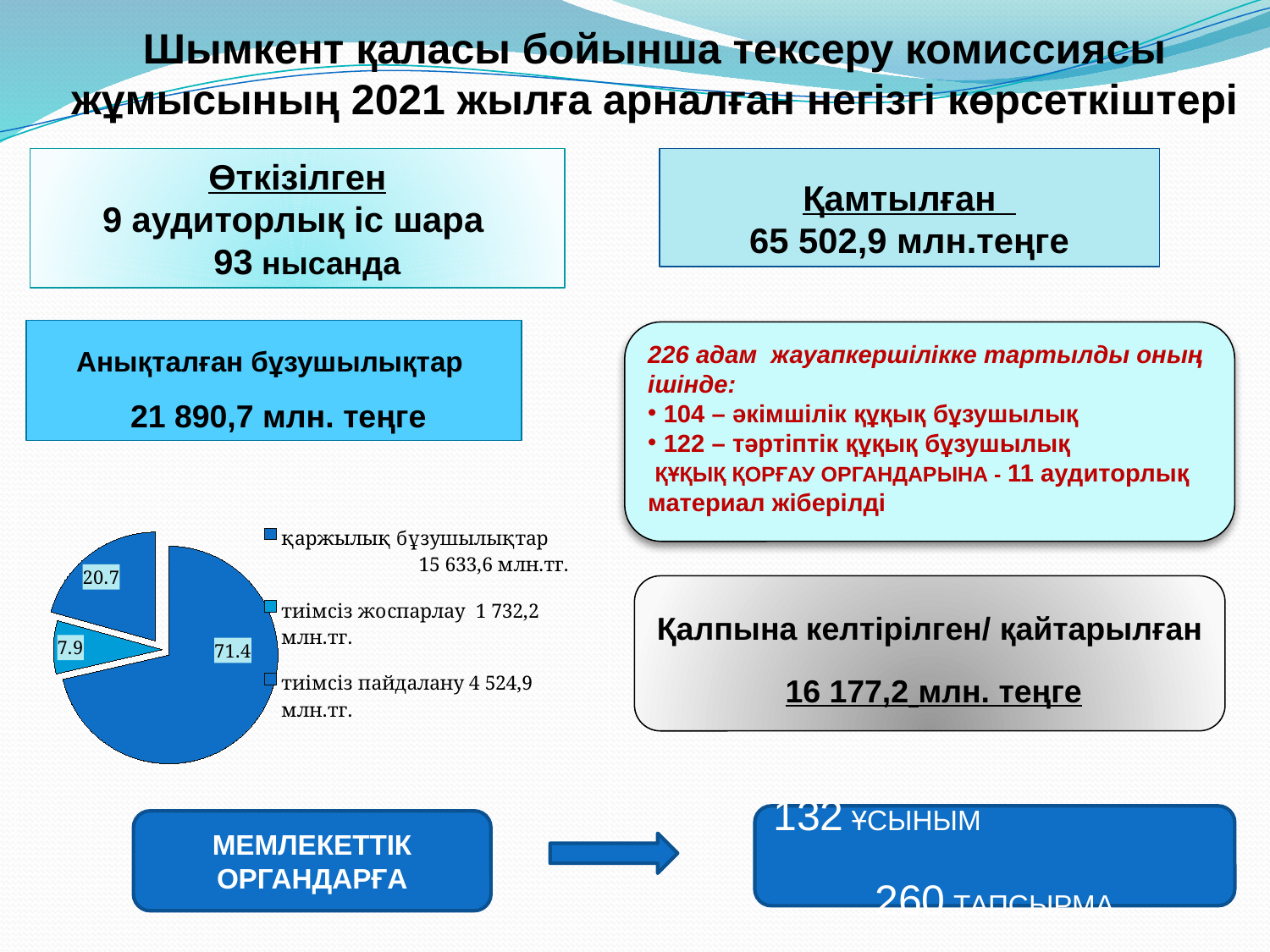
How many entries does the legend of the pie chart list? 3 According to the legend, what amount in млн.тг. is given for қаржылық бұзушылықтар? 15 633,6 млн.тг. According to the legend, what amount in млн.тг. is given for тиімсіз пайдалану? 4 524,9 млн.тг. What kind of chart is shown on the slide? pie chart Which legend category corresponds to the largest slice of the pie chart? қаржылық бұзушылықтар What is the difference between the slice labelled 20.7 and the slice labelled 7.9? 12.8 What is the difference between the slice labelled 71.4 and the slice labelled 20.7? 50.7 How many slices does the pie chart have? 3 Which legend category corresponds to the smallest slice of the pie chart? тиімсіз жоспарлау Which slice is larger: the one labelled 20.7 or the one labelled 7.9? 20.7 What value is labelled on the smallest slice of the pie chart? 7.9 What value is labelled on the largest slice of the pie chart? 71.4